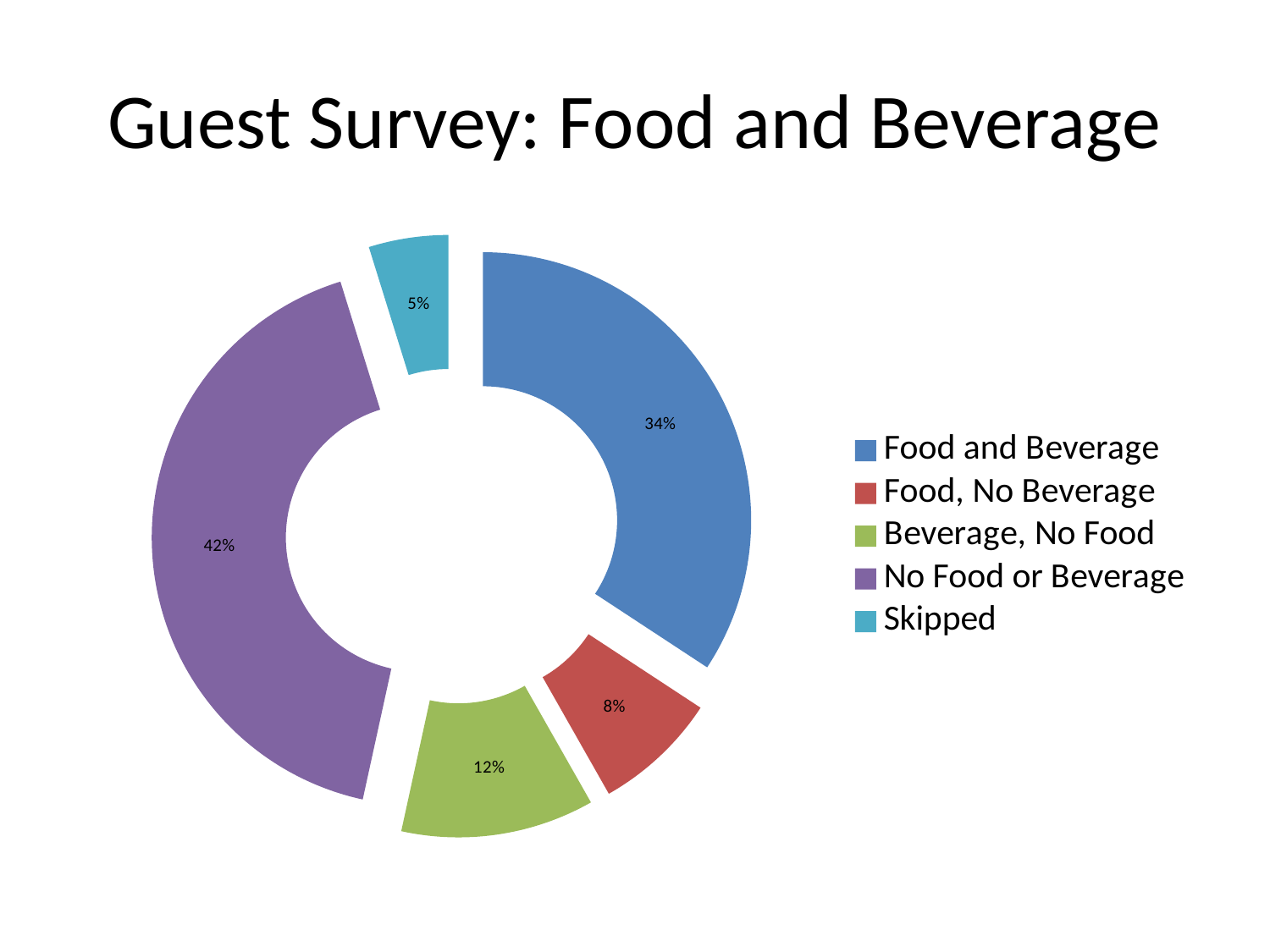
Which category has the smallest share of the chart? Skipped How many categories are shown in the chart? 5 What percentage of responses were Skipped? 5% Which is larger, Food, No Beverage or Beverage, No Food? Beverage, No Food What kind of chart is shown on the slide? Doughnut (pie) chart What percentage of guests chose Food and Beverage? 34% What percentage of guests chose No Food or Beverage? 42% What is the title of the slide? Guest Survey: Food and Beverage What colour represents the Skipped category? Teal (light blue) What percentage of guests chose Beverage, No Food? 12% Which category has the largest share of the chart? No Food or Beverage What is the difference in percentage points between No Food or Beverage and Food and Beverage? 8